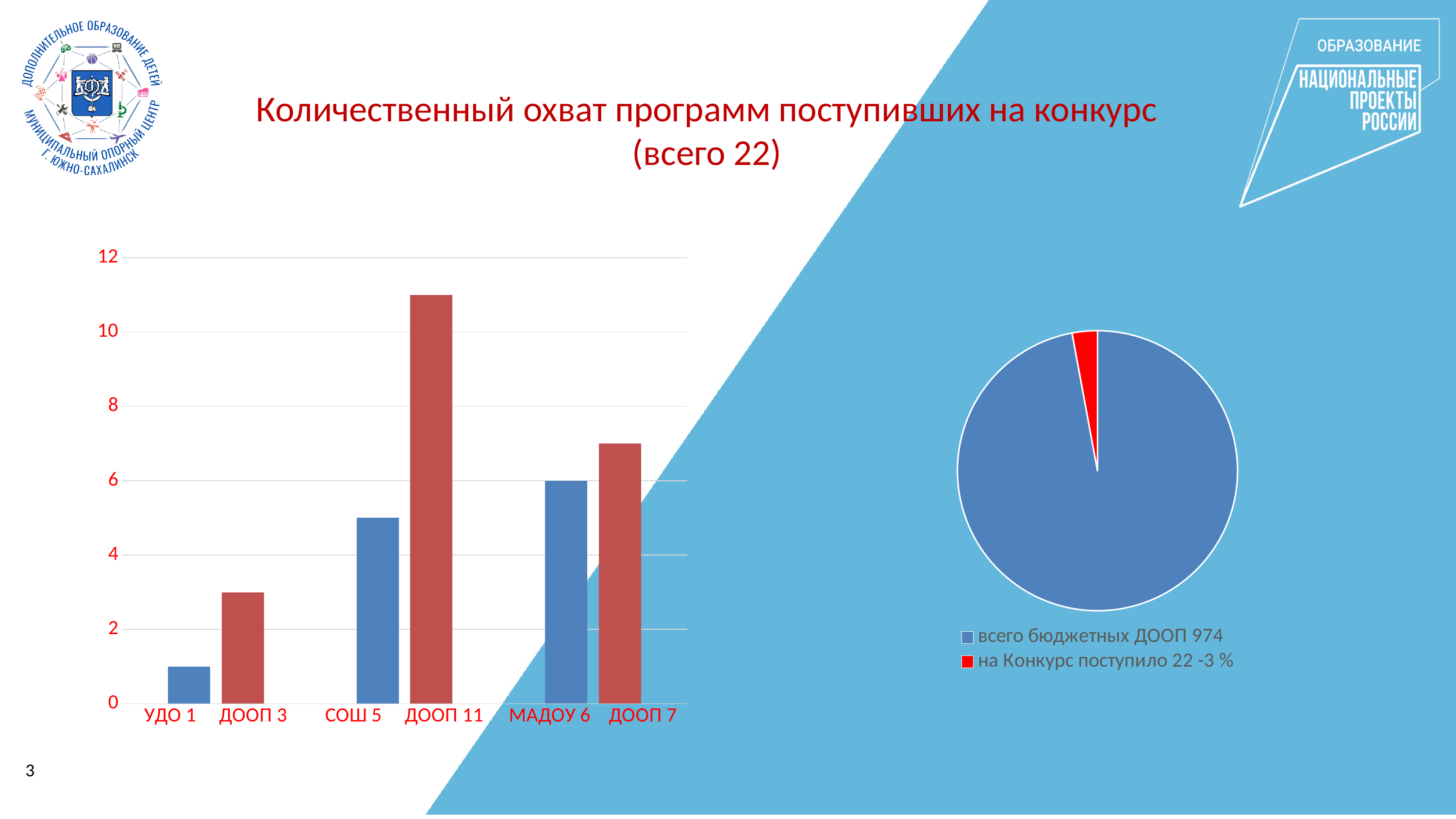
In the bar chart on the left, how many bars are plotted? 6 In the bar chart on the left, which category has the highest bar? ДООП 11 What kind of chart is the chart on the left side of the slide? bar chart In the bar chart on the left, which category has the lowest bar? УДО 1 In the pie chart on the right, which slice is larger: всего бюджетных ДООП 974 or на Конкурс поступило 22 -3 %? всего бюджетных ДООП 974 What kind of chart is the chart on the right side of the slide? pie chart In the pie chart on the right, what number is given in the legend for всего бюджетных ДООП? 974 In the bar chart on the left, which bar is taller: ДООП 7 or МАДОУ 6? ДООП 7 In the pie chart on the right, how many entries does the legend list? 2 In the bar chart on the left, what is the difference between the values for ДООП 11 and СОШ 5? 6 In the bar chart on the left, is the value for ДООП 11 greater or less than 10? greater In the bar chart on the left, what is the value of the bar for МАДОУ 6? 6